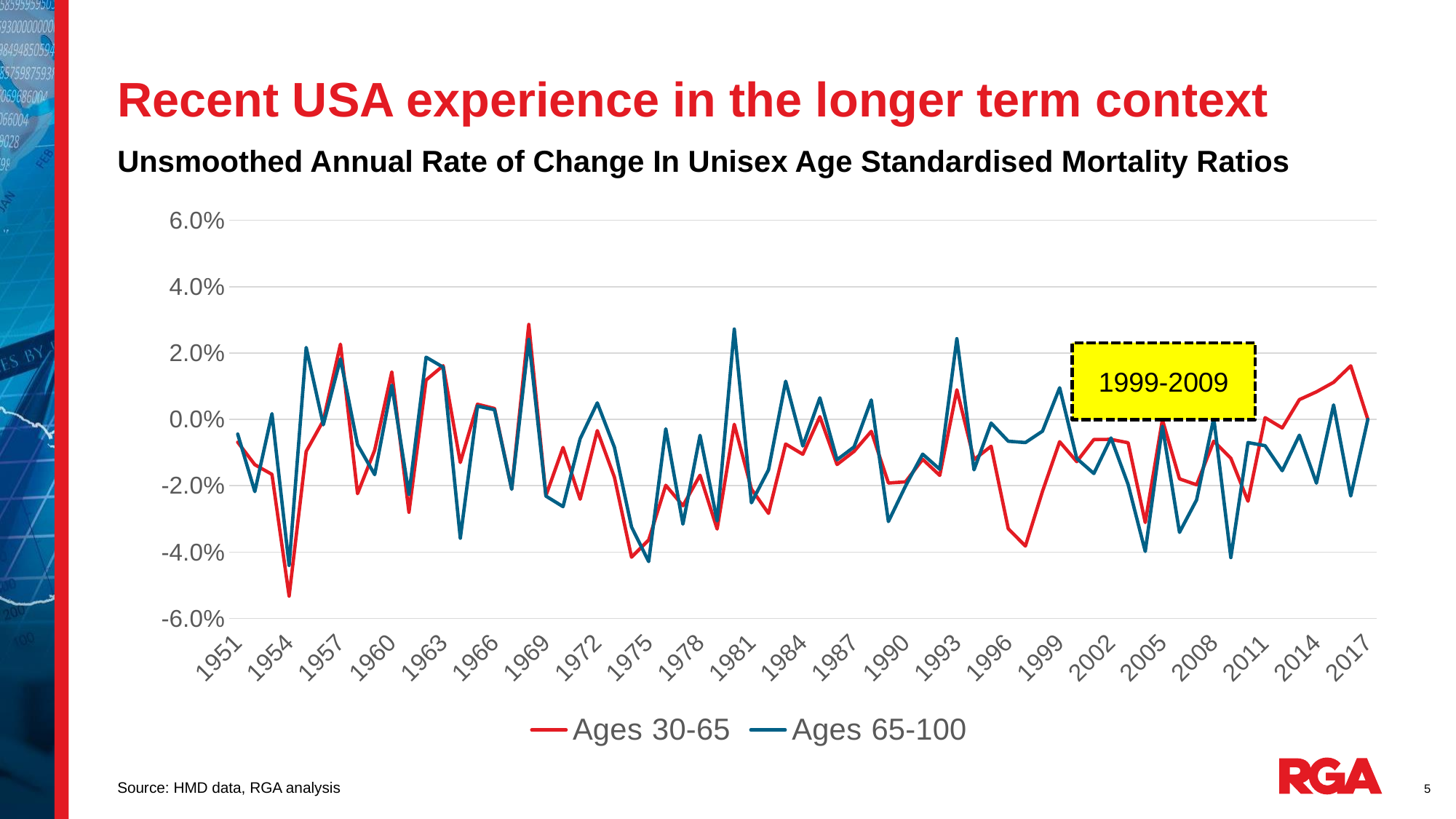
Is the value for Ages 30-65 in 1975 greater or less than -2.0%? less Is the value for Ages 65-100 in 1981 greater or less than 2.0%? less What kind of chart is shown on the slide? Line chart Is the value for Ages 30-65 in 2014 greater or less than 0.0%? greater How many series does the legend list? 2 In 2014, which series has the higher value, Ages 30-65 or Ages 65-100? Ages 30-65 In which labelled year does the Ages 30-65 series reach its lowest value? 1954 What are the two series named in the legend? Ages 30-65 and Ages 65-100 What year range is highlighted in the yellow box on the chart? 1999-2009